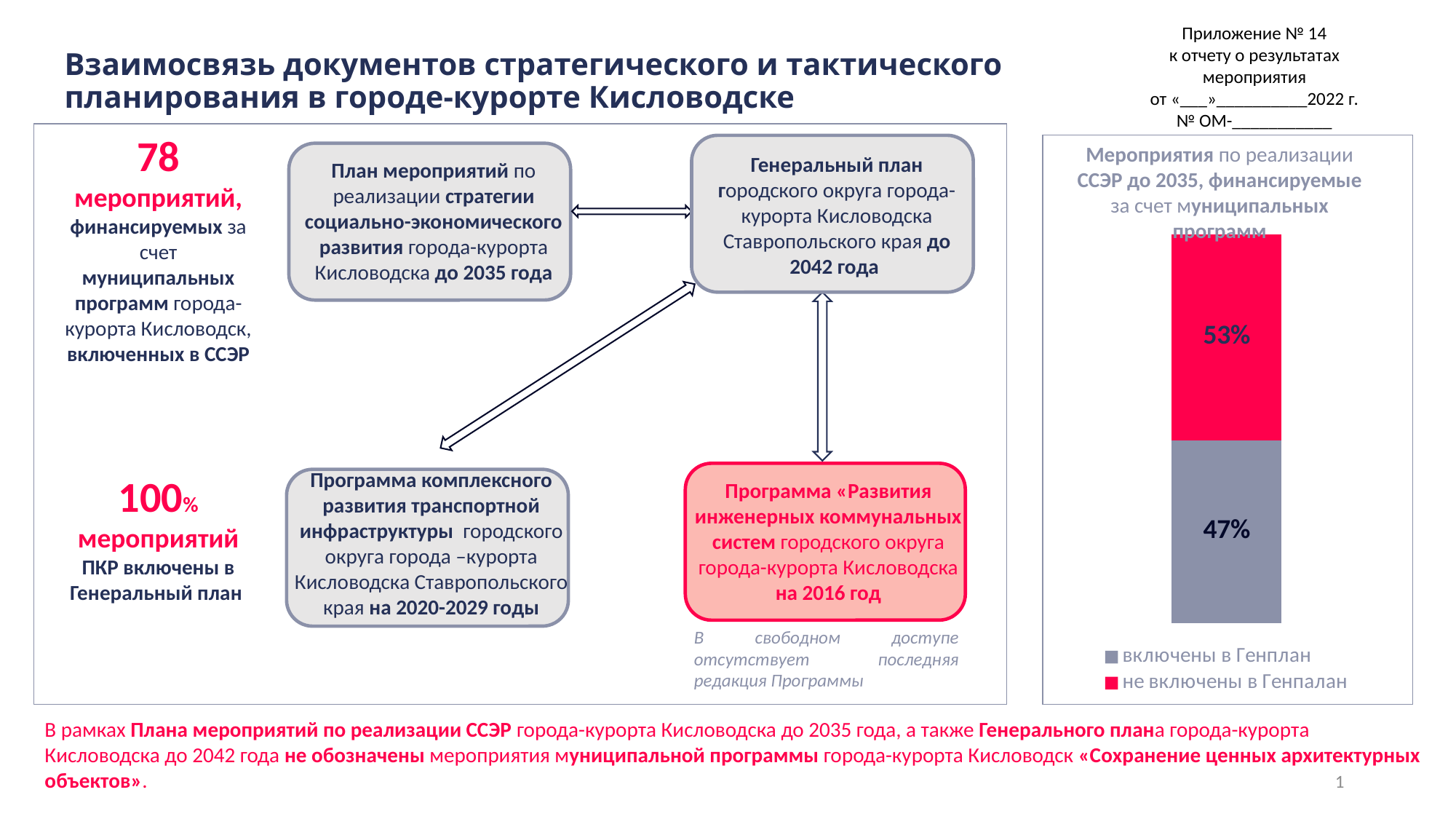
What is the total of the two segments in the stacked bar? 100% What is the difference in percentage points between the "не включены в Генпалан" and "включены в Генплан" segments? 6 How many series does the chart legend list? 2 What colour is the "включены в Генплан" segment of the bar? Grey What kind of chart is shown on the right side of the slide? Stacked bar chart What colour is the "не включены в Генпалан" segment of the bar? Red Which segment of the stacked bar is larger: "включены в Генплан" or "не включены в Генпалан"? не включены в Генпалан What share of the stacked bar is labelled "включены в Генплан"? 47% Is the share for "включены в Генплан" greater or less than 50%? less Which legend entry has the largest share in the stacked bar? не включены в Генпалан Which legend entry has the smallest share in the stacked bar? включены в Генплан What share of the stacked bar is labelled "не включены в Генпалан"? 53%